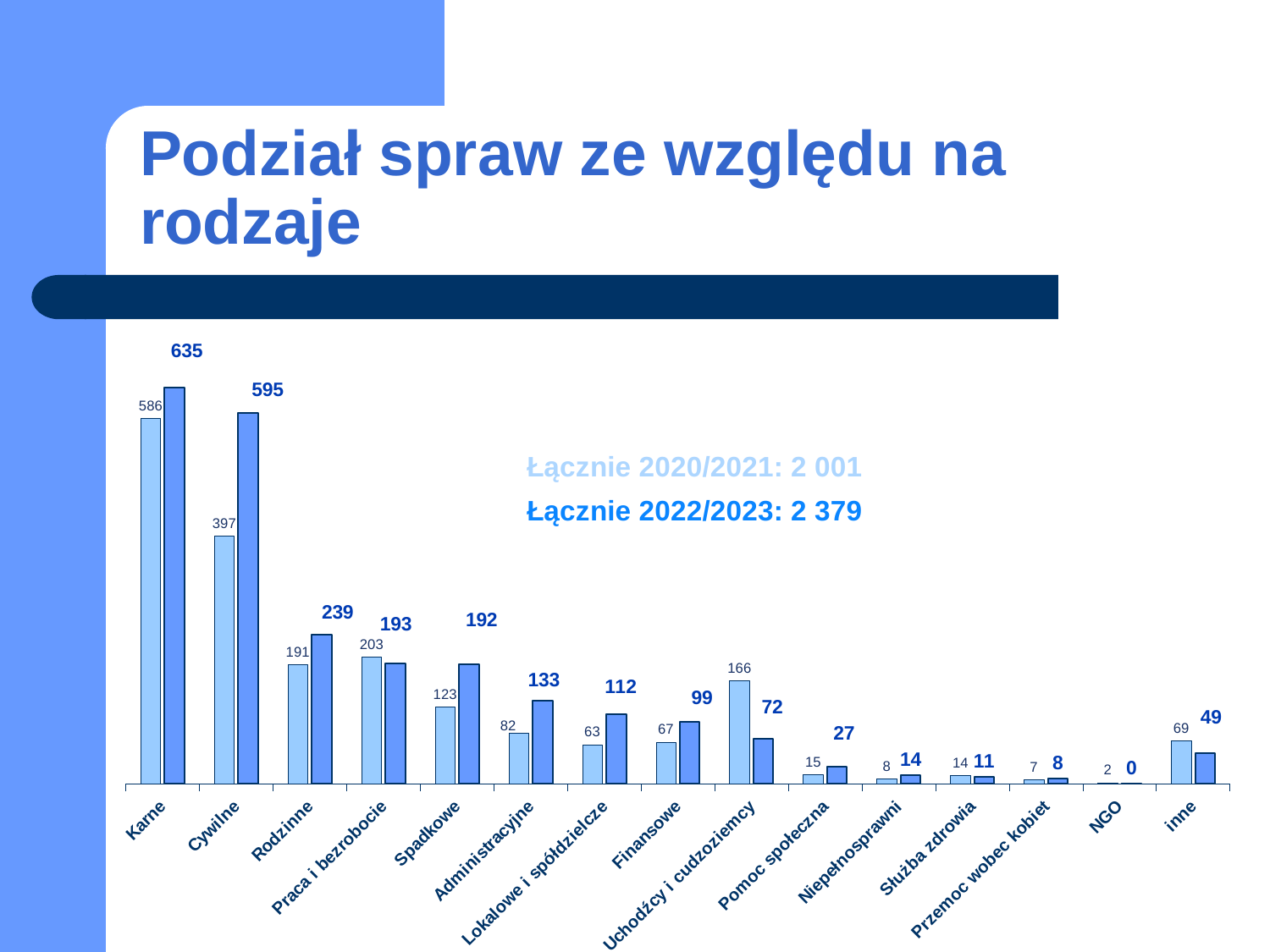
Which category has the highest 2022/2023 (dark blue) value? Karne What is the 2022/2023 (dark blue) value for Karne? 635 How many categories are shown on the x axis? 15 Which category has the lowest 2022/2023 (dark blue) value? NGO What is the 2020/2021 (light blue) value for Cywilne? 397 What is the difference between the 2022/2023 and 2020/2021 values for Cywilne? 198 What kind of chart is shown on the slide? Bar chart What is the difference between the 2020/2021 and 2022/2023 values for Uchodźcy i cudzoziemcy? 94 What total is given for 2022/2023 in the text on the chart? 2 379 What is the 2022/2023 (dark blue) value for Spadkowe? 192 What is the 2020/2021 (light blue) value for Uchodźcy i cudzoziemcy? 166 For Praca i bezrobocie, which is larger: the 2020/2021 value or the 2022/2023 value? 2020/2021 (203)